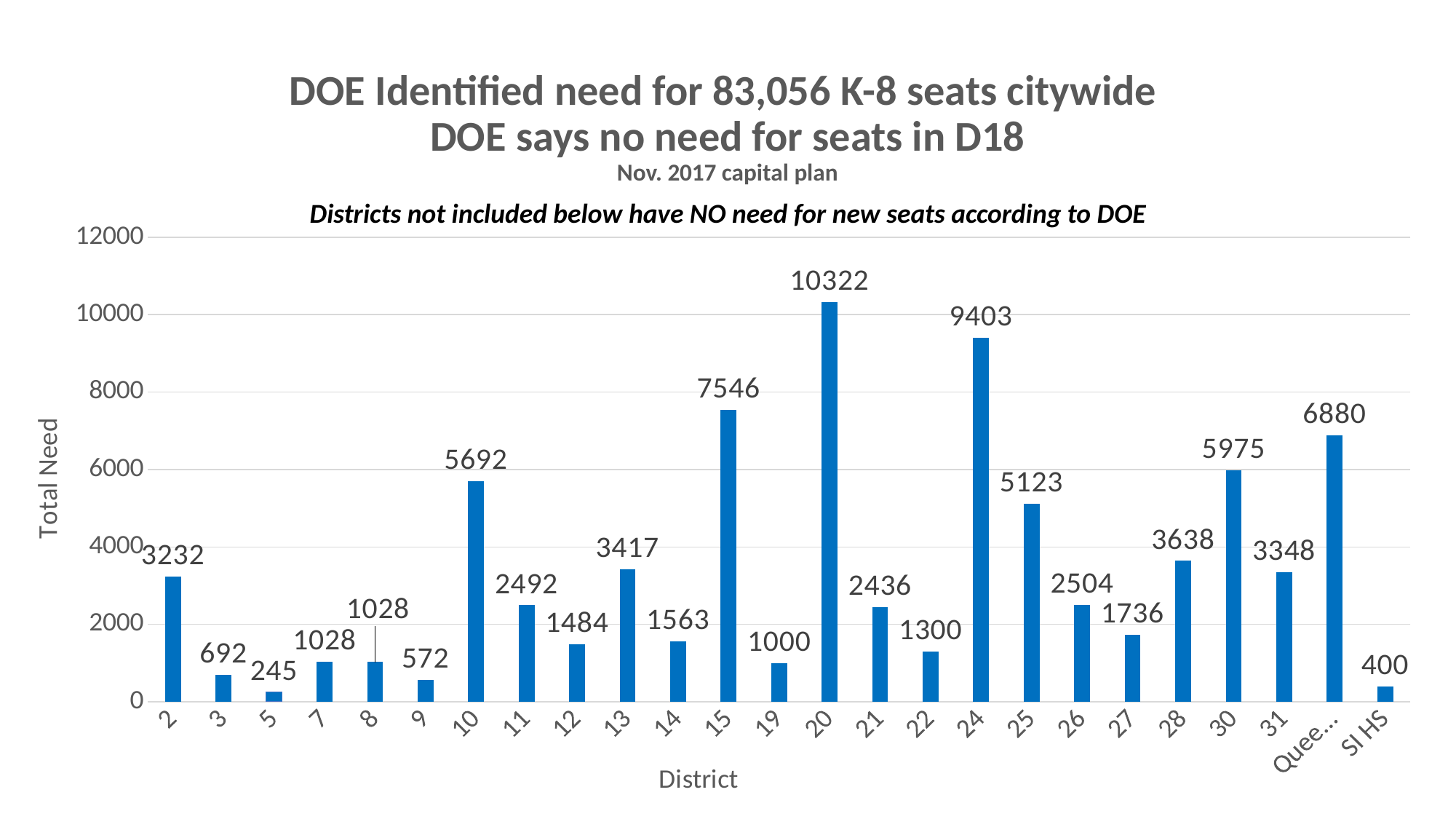
Is the value for District 28 greater or less than 4000? less What is the total need for District 31? 3348 Which has a larger total need, District 10 or District 30? District 30 What is the label of the y axis? Total Need Which district has the lowest total need? 5 What is the difference in total need between District 24 and District 25? 4280 What is the total need for District 15? 7546 What is the total need for District 20? 10322 Which district has the highest total need? 20 How many districts are shown on the x axis? 25 What is the total need for SI HS? 400 What kind of chart is shown on the slide? Bar chart